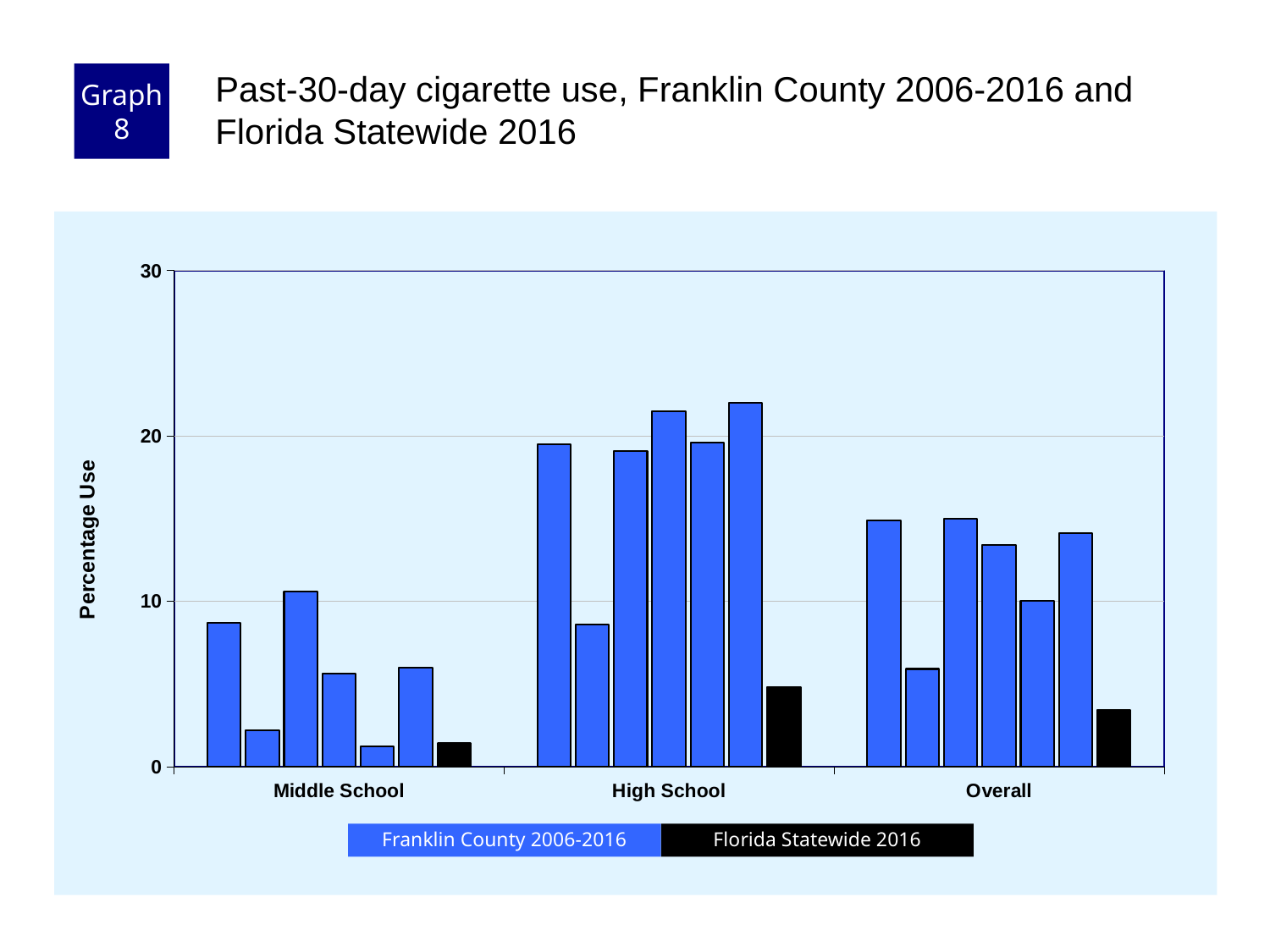
Is the Florida Statewide 2016 value for Overall greater or less than 10? less Is the Florida Statewide 2016 value for High School greater or less than 10? less What kind of chart is shown on the slide? bar chart How many categories are shown on the x axis? 3 What colour represents Florida Statewide 2016 in the legend? black Is the tallest Franklin County 2006-2016 bar for High School greater or less than 20? greater Which category has the highest Florida Statewide 2016 value? High School Which category has the lowest Florida Statewide 2016 value? Middle School Which is larger, the Florida Statewide 2016 value for High School or for Middle School? High School How many series does the legend list? 2 What is the label on the y axis? Percentage Use